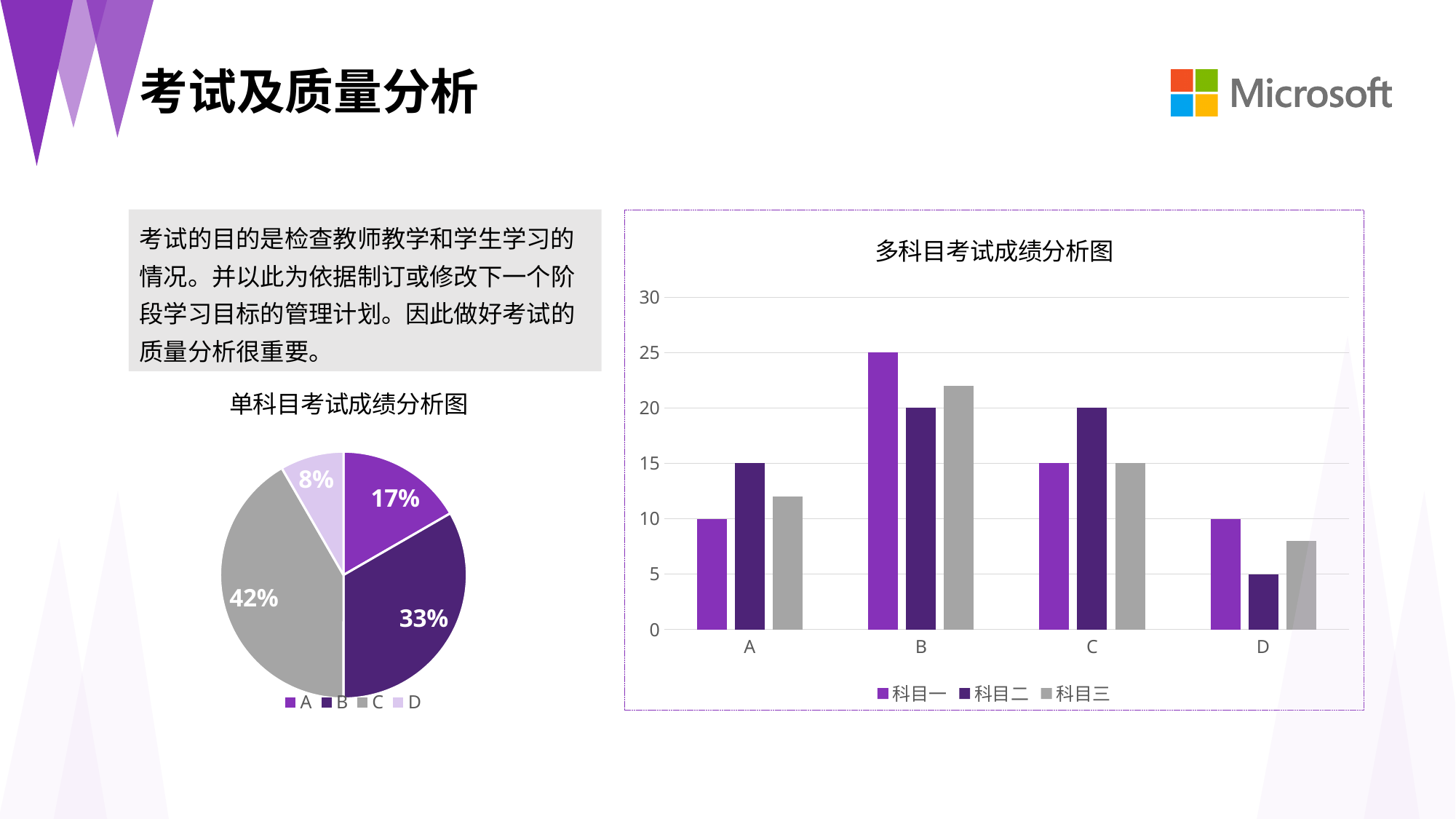
In the bar chart 多科目考试成绩分析图, is the value of 科目三 for category B greater or less than 20? greater What kind of chart is 多科目考试成绩分析图? bar chart In the bar chart 多科目考试成绩分析图, what is the value of 科目二 for category D? 5 In the pie chart 单科目考试成绩分析图, what share does slice C have? 42% In the pie chart 单科目考试成绩分析图, which slice is the largest? C In the pie chart 单科目考试成绩分析图, which slice is the smallest? D In the pie chart 单科目考试成绩分析图, what is the difference between the shares of B and A? 16% In the pie chart 单科目考试成绩分析图, how many slices are there? 4 In the pie chart 单科目考试成绩分析图, what share does slice D have? 8% In the bar chart 多科目考试成绩分析图, what is the value of 科目一 for category B? 25 In the bar chart 多科目考试成绩分析图, how many series does the legend list? 3 In the bar chart 多科目考试成绩分析图, which category has the highest 科目一 value? B